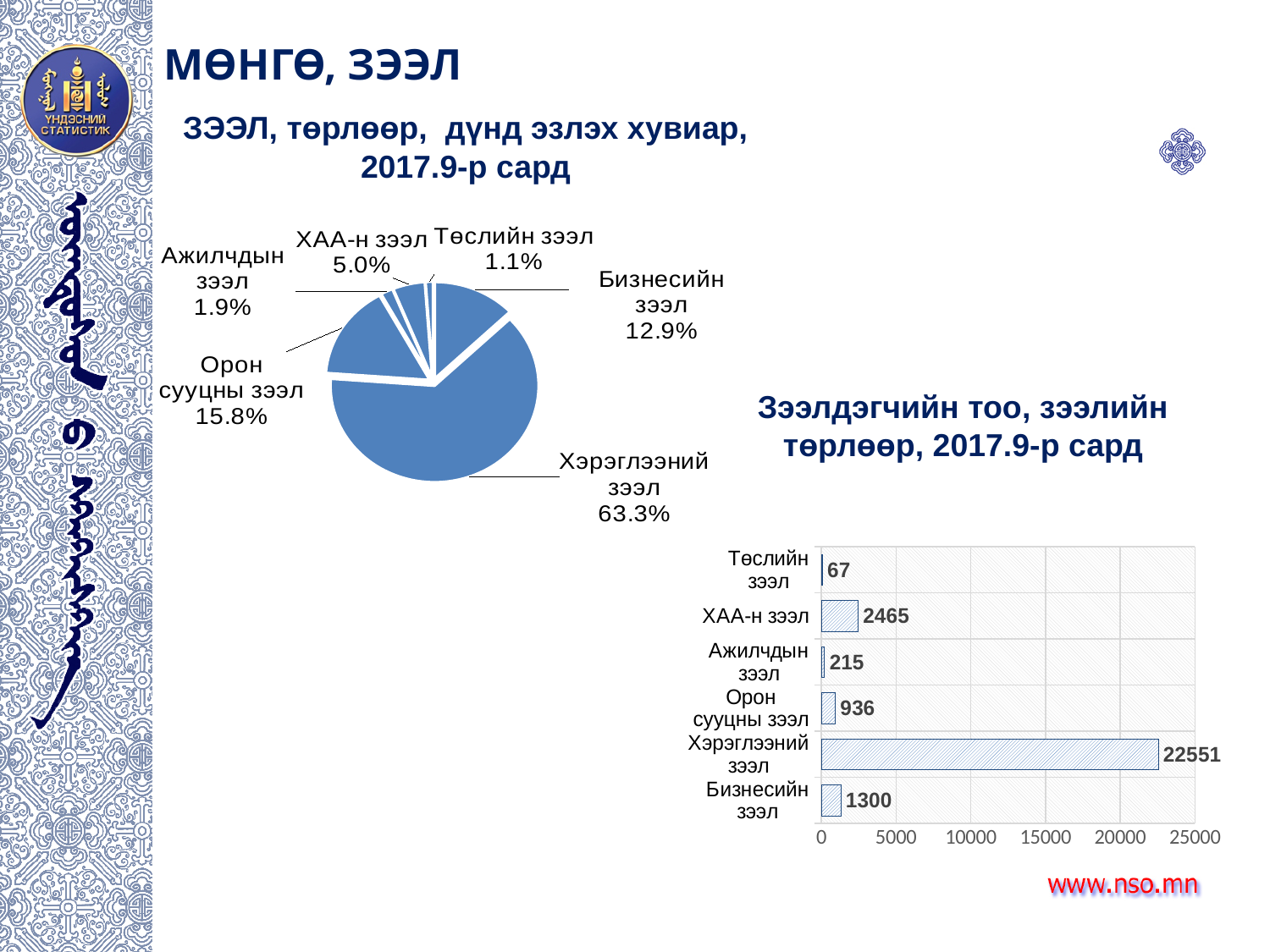
In the pie chart 'ЗЭЭЛ, төрлөөр, дүнд эзлэх хувиар, 2017.9-р сард', what share does Хэрэглээний зээл have? 63.3% In the pie chart 'ЗЭЭЛ, төрлөөр, дүнд эзлэх хувиар, 2017.9-р сард', how many slices are there? 6 In the pie chart 'ЗЭЭЛ, төрлөөр, дүнд эзлэх хувиар, 2017.9-р сард', which loan type has the smallest share? Төслийн зээл What type of chart is 'Зээлдэгчийн тоо, зээлийн төрлөөр, 2017.9-р сард'? bar chart In the bar chart 'Зээлдэгчийн тоо, зээлийн төрлөөр, 2017.9-р сард', what is the value for Хэрэглээний зээл? 22551 In the bar chart 'Зээлдэгчийн тоо, зээлийн төрлөөр, 2017.9-р сард', what is the value for ХАА-н зээл? 2465 In the bar chart 'Зээлдэгчийн тоо, зээлийн төрлөөр, 2017.9-р сард', what is the difference between Бизнесийн зээл and Ажилчдын зээл? 1085 In the pie chart 'ЗЭЭЛ, төрлөөр, дүнд эзлэх хувиар, 2017.9-р сард', what is the difference between the shares of Бизнесийн зээл and ХАА-н зээл? 7.9% In the pie chart 'ЗЭЭЛ, төрлөөр, дүнд эзлэх хувиар, 2017.9-р сард', what share does Орон сууцны зээл have? 15.8% In the bar chart 'Зээлдэгчийн тоо, зээлийн төрлөөр, 2017.9-р сард', which is larger: Орон сууцны зээл or Бизнесийн зээл? Бизнесийн зээл In the bar chart 'Зээлдэгчийн тоо, зээлийн төрлөөр, 2017.9-р сард', which loan type has the lowest number of borrowers? Төслийн зээл In the bar chart 'Зээлдэгчийн тоо, зээлийн төрлөөр, 2017.9-р сард', what is the maximum value shown on the x axis? 25000